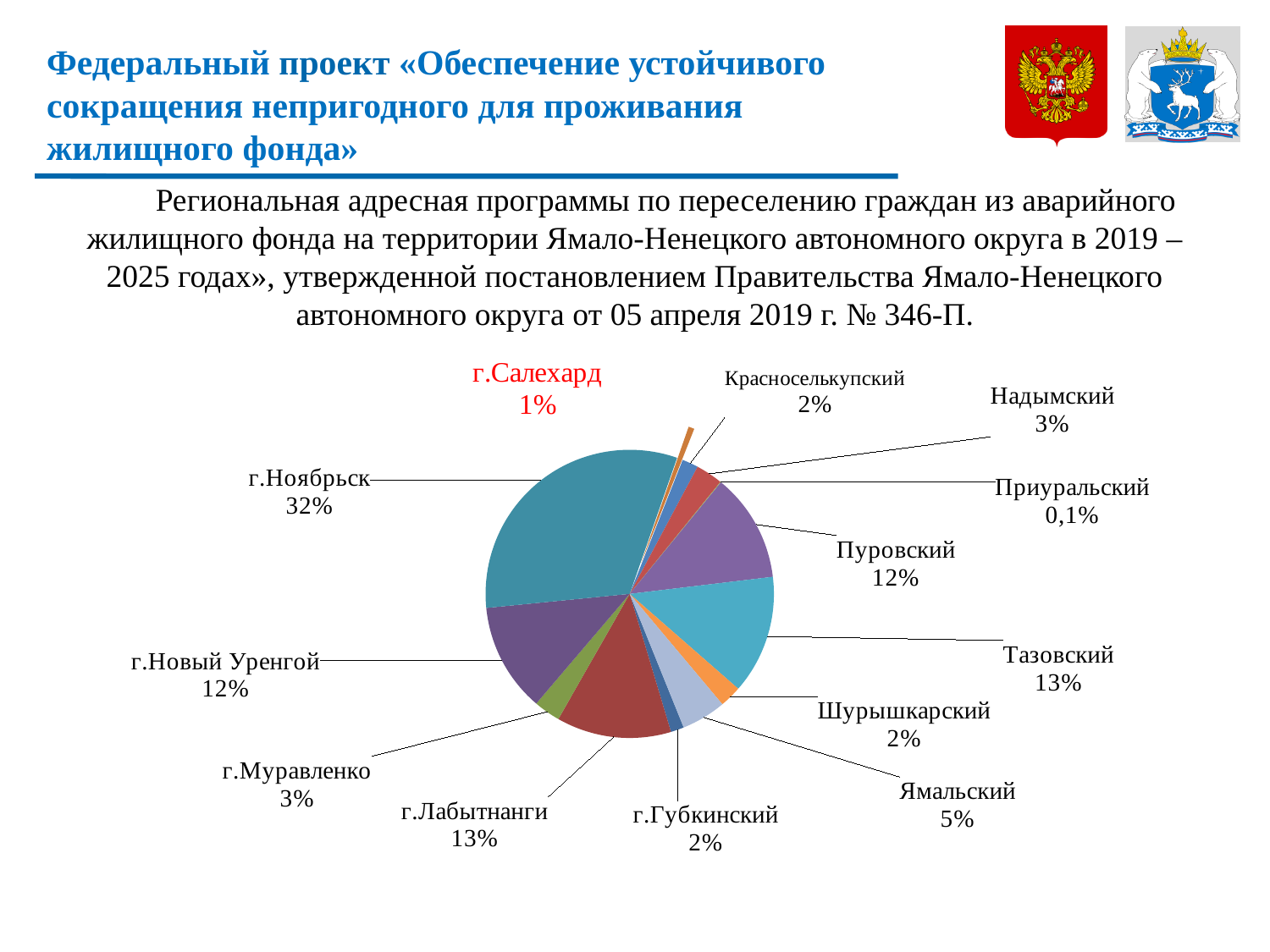
What share of the pie chart does г.Ноябрьск account for? 32% Which category has the smallest slice of the pie chart? Приуральский Which category has the largest slice of the pie chart? г.Ноябрьск What is the difference in percentage points between Ямальский and Надымский? 2% What is the value shown for Тазовский in the pie chart? 13% What is the difference in percentage points between г.Ноябрьск and Тазовский? 19% Which is larger in the pie chart, Пуровский or Ямальский? Пуровский How many categories are shown in the pie chart? 13 What is the value shown for Приуральский in the pie chart? 0,1% What is the value shown for Ямальский in the pie chart? 5% What is the value shown for г.Лабытнанги in the pie chart? 13% What type of chart is shown on the slide? Pie chart